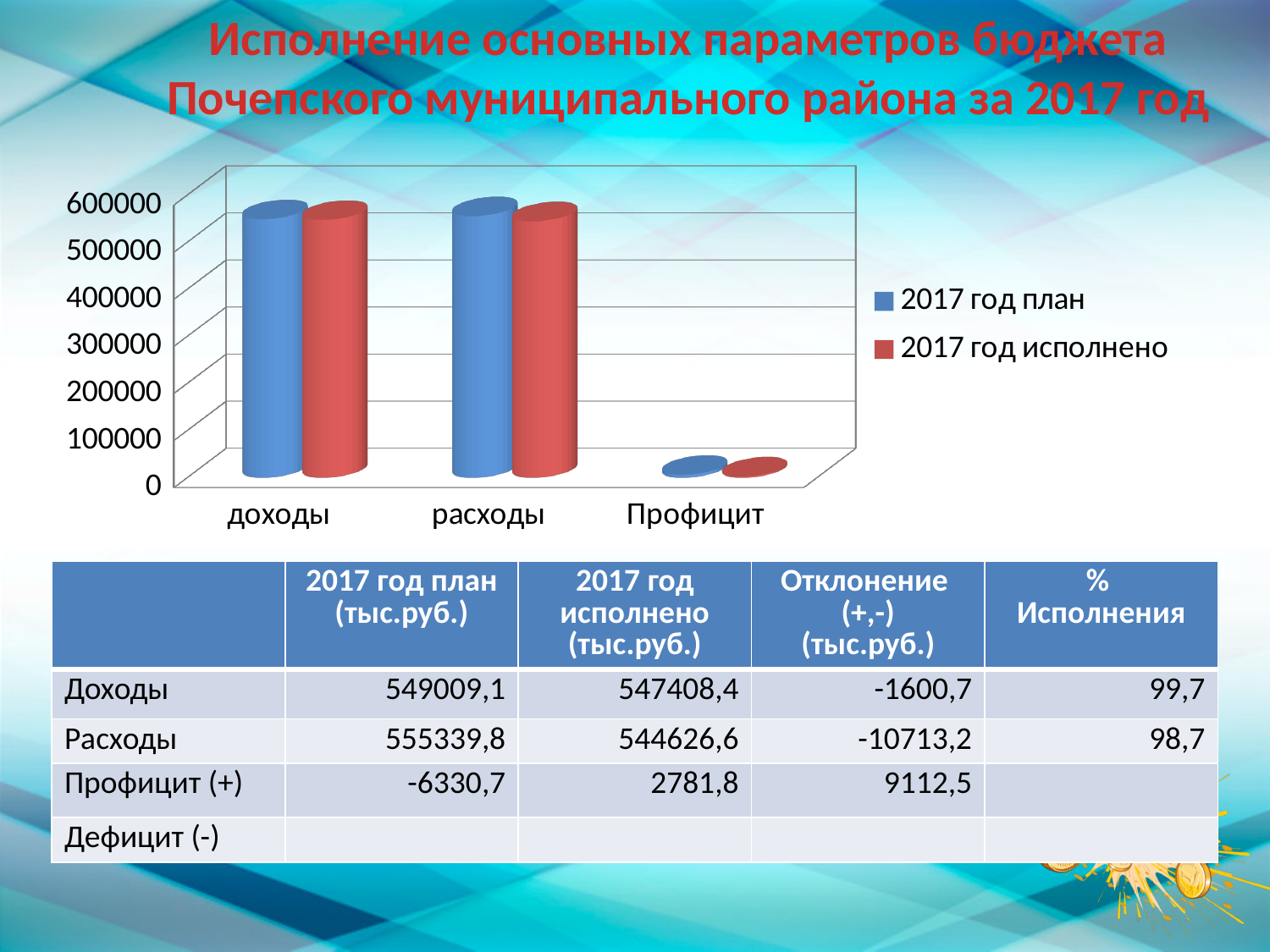
According to the table on the slide, what is the '% Исполнения' for Доходы? 99,7 In the chart, is the value of '2017 год исполнено' for расходы greater or less than 400000? greater What are the two legend entries of the chart? 2017 год план; 2017 год исполнено According to the table on the slide, what is the '2017 год исполнено' value for Расходы (тыс.руб.)? 544626,6 In the chart, is the value of '2017 год план' for доходы greater or less than 500000? greater In the chart, is the value of '2017 год исполнено' for Профицит greater or less than 100000? less How many series does the chart legend list? 2 Using the table values, which is larger: the 2017 plan for Доходы or the 2017 plan for Расходы? Расходы How many categories are shown on the x axis of the chart? 3 What kind of chart is shown on the slide? bar chart According to the table on the slide, what is the '2017 год план' value for Доходы (тыс.руб.)? 549009,1 Which category has the lowest bars in the chart? Профицит